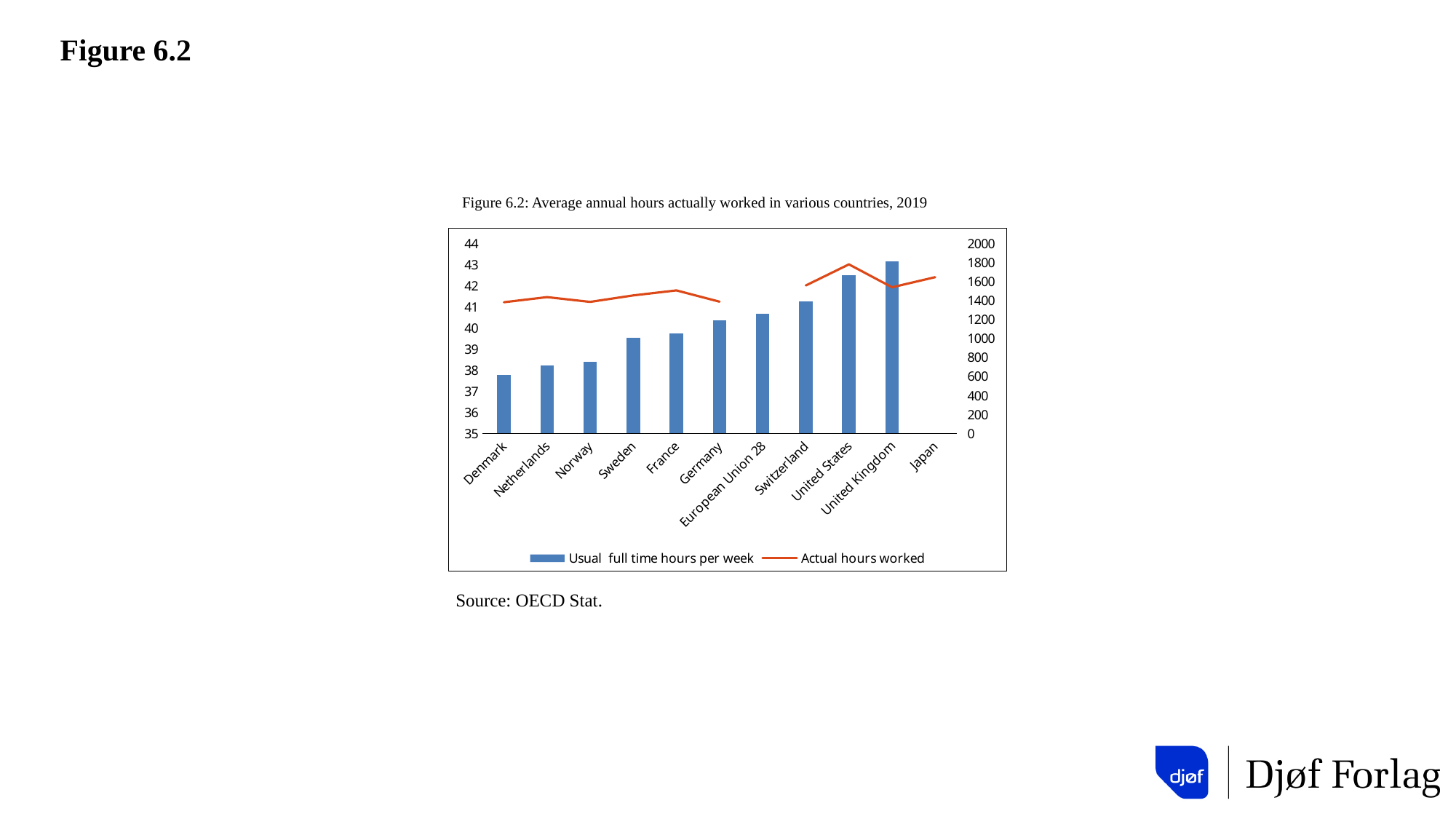
Do the usual full time hours per week bars rise or fall from Denmark to the United Kingdom? rise Which country has the shortest bar for usual full time hours per week? Denmark Which country has the tallest bar for usual full time hours per week? United Kingdom Is the actual hours worked value for the United States greater or less than 1600? greater Which has the taller usual full time hours per week bar, Germany or Sweden? Germany Is the actual hours worked value for Denmark greater or less than 1600? less Is the usual full time hours per week bar for Denmark greater or less than 38? less How many countries or regions are labelled on the x axis? 11 What kind of chart is shown on the slide? A combined bar and line chart How many series does the legend list? 2 Which country has the highest point on the actual hours worked line? United States